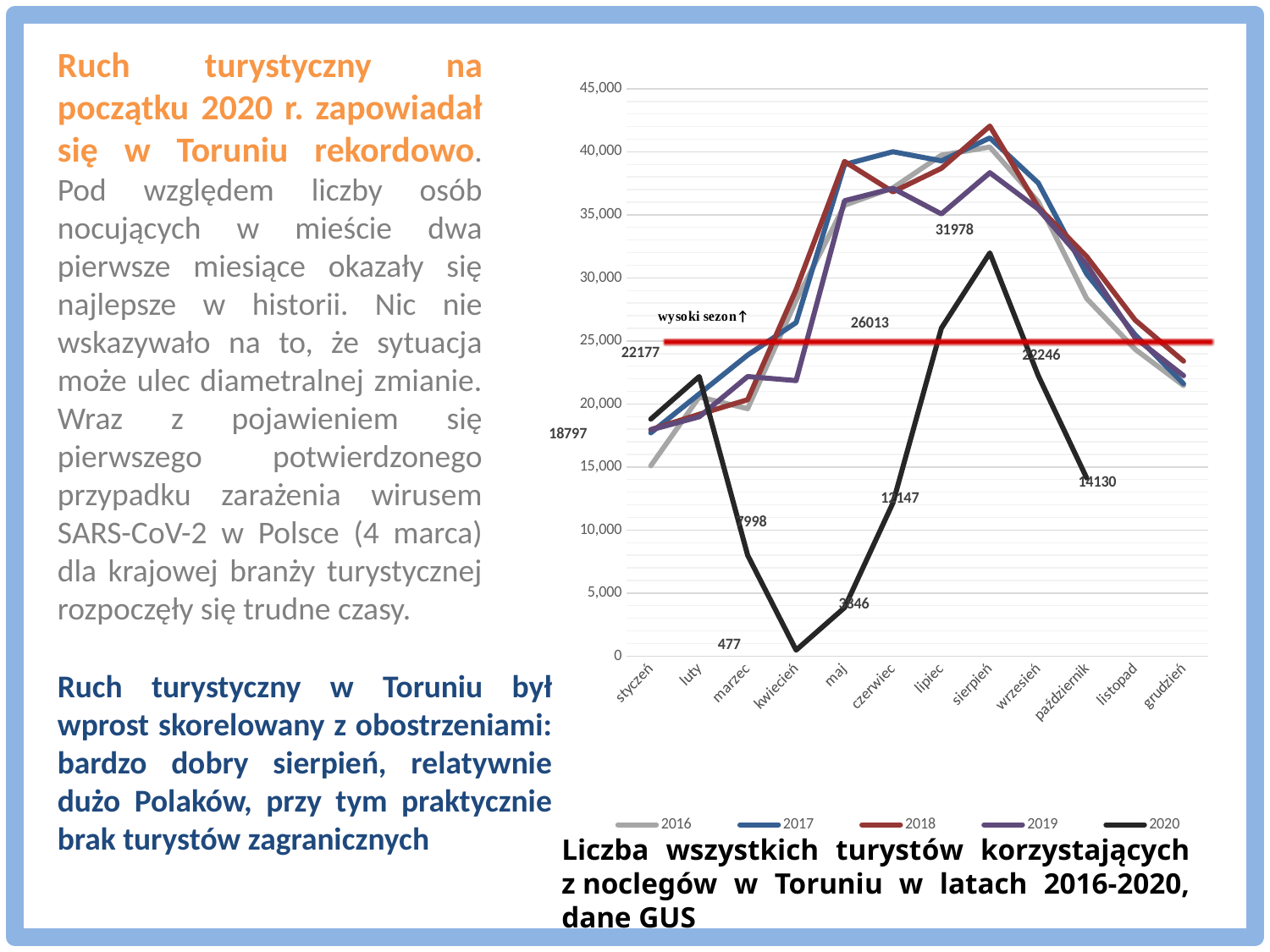
What is the difference between the 2020 values for sierpień and lipiec? 5965 Is the value for 2018 in sierpień greater or less than 40,000? greater How many months are shown on the x axis? 12 What label is written above the red horizontal line? wysoki sezon What is the value for 2020 in sierpień? 31978 What is the value for 2020 in kwiecień? 477 How many series does the legend list? 5 What kind of chart is shown on the slide? line chart In which month is the 2020 value highest? sierpień What is the value for 2020 in październik? 14130 Which is larger for 2020: luty or marzec? luty In which month is the 2020 value lowest? kwiecień